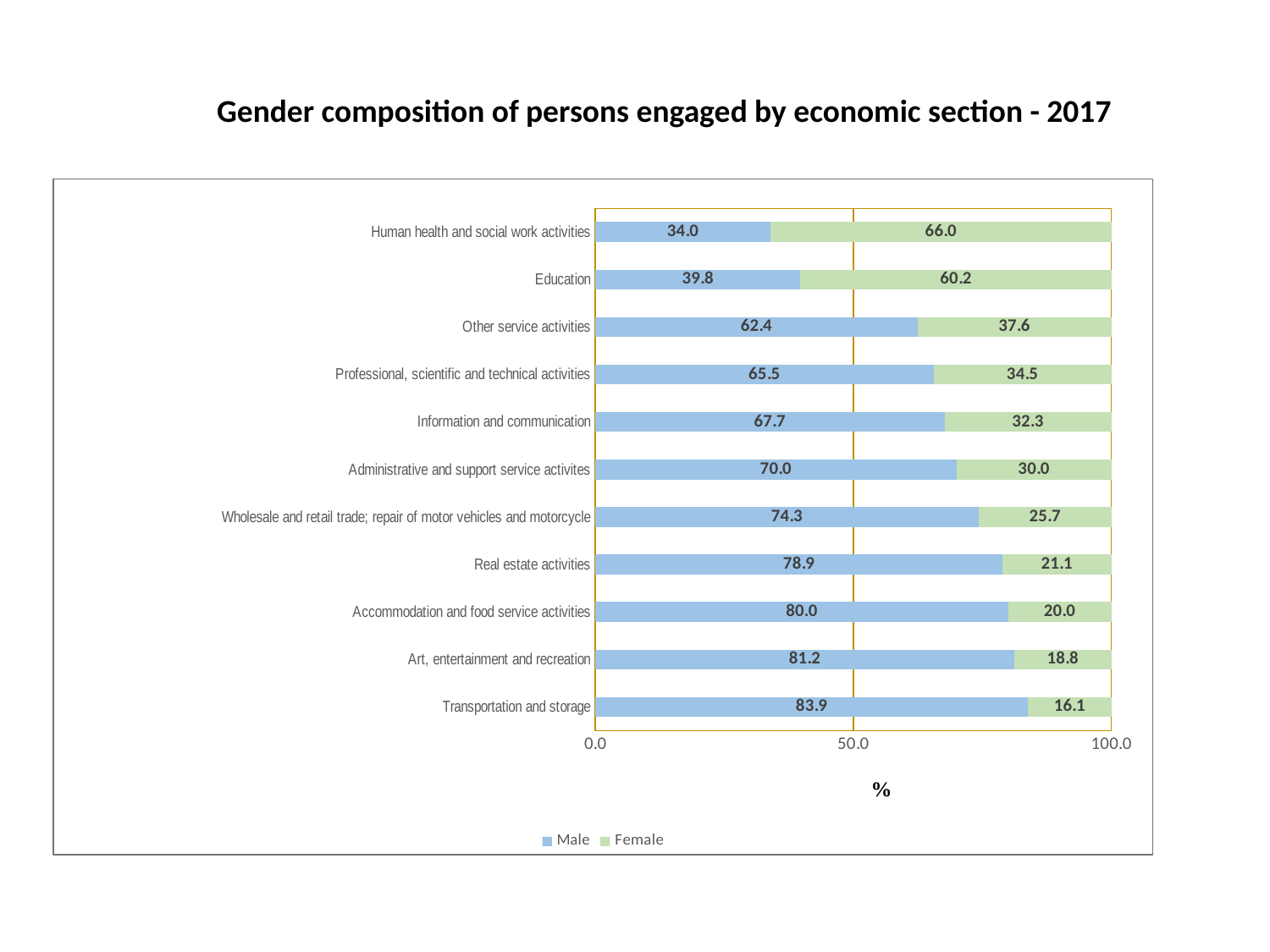
What kind of chart is shown on the slide? Stacked bar chart Which category has the lowest Male value? Human health and social work activities How many series does the legend list? 2 Is the Male value for Real estate activities greater or less than 50.0? greater Which category has the highest Male value? Transportation and storage What is the Male value for Wholesale and retail trade; repair of motor vehicles and motorcycle? 74.3 What is the Female value for Transportation and storage? 16.1 What is the Male value for Education? 39.8 What is the total of the stacked bar for Administrative and support service activites? 100.0 How many economic sections are shown on the chart? 11 Which is larger: the Female value for Education or the Female value for Other service activities? Education What is the difference between the Male and Female values for Information and communication? 35.4